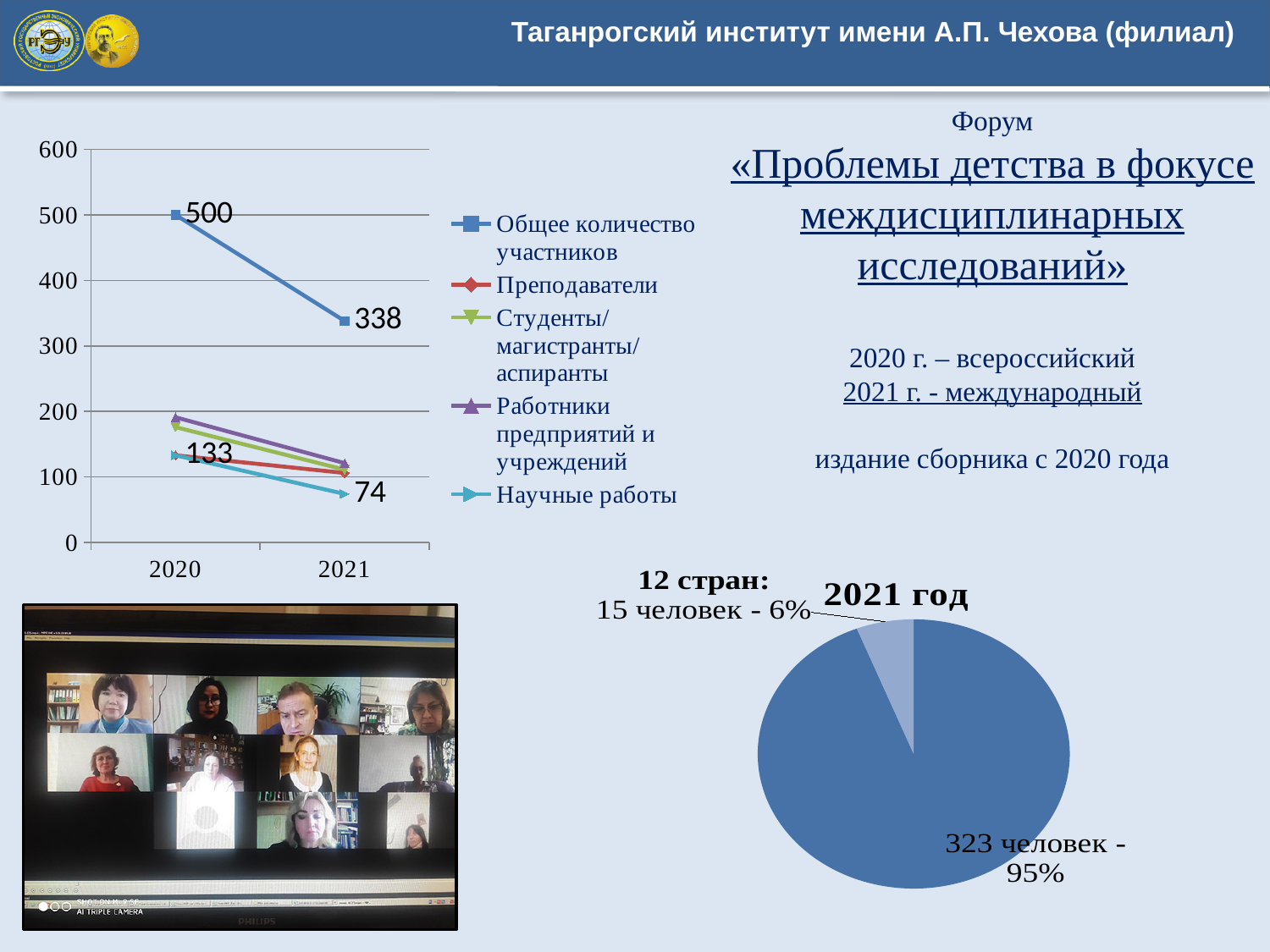
How many series does the legend of the line chart on the left list? 5 What kind of chart is the chart titled 2021 год? pie chart In the line chart on the left, what is the value for Общее количество участников in 2020? 500 In the line chart on the left, what is the difference between the Научные работы values for 2020 and 2021? 59 In the line chart on the left, what is the value for Общее количество участников in 2021? 338 In the line chart on the left, what is the value for Научные работы in 2020? 133 In the line chart on the left, is the value for Работники предприятий и учреждений in 2020 greater or less than 100? greater In the line chart on the left, what is the value for Научные работы in 2021? 74 In the line chart on the left, does the Общее количество участников series rise or fall from 2020 to 2021? fall What kind of chart is the chart on the left of the slide? line chart In the pie chart titled 2021 год, what share does the slice for 323 человек represent? 95% In the line chart on the left, by how much did Общее количество участников decrease from 2020 to 2021? 162